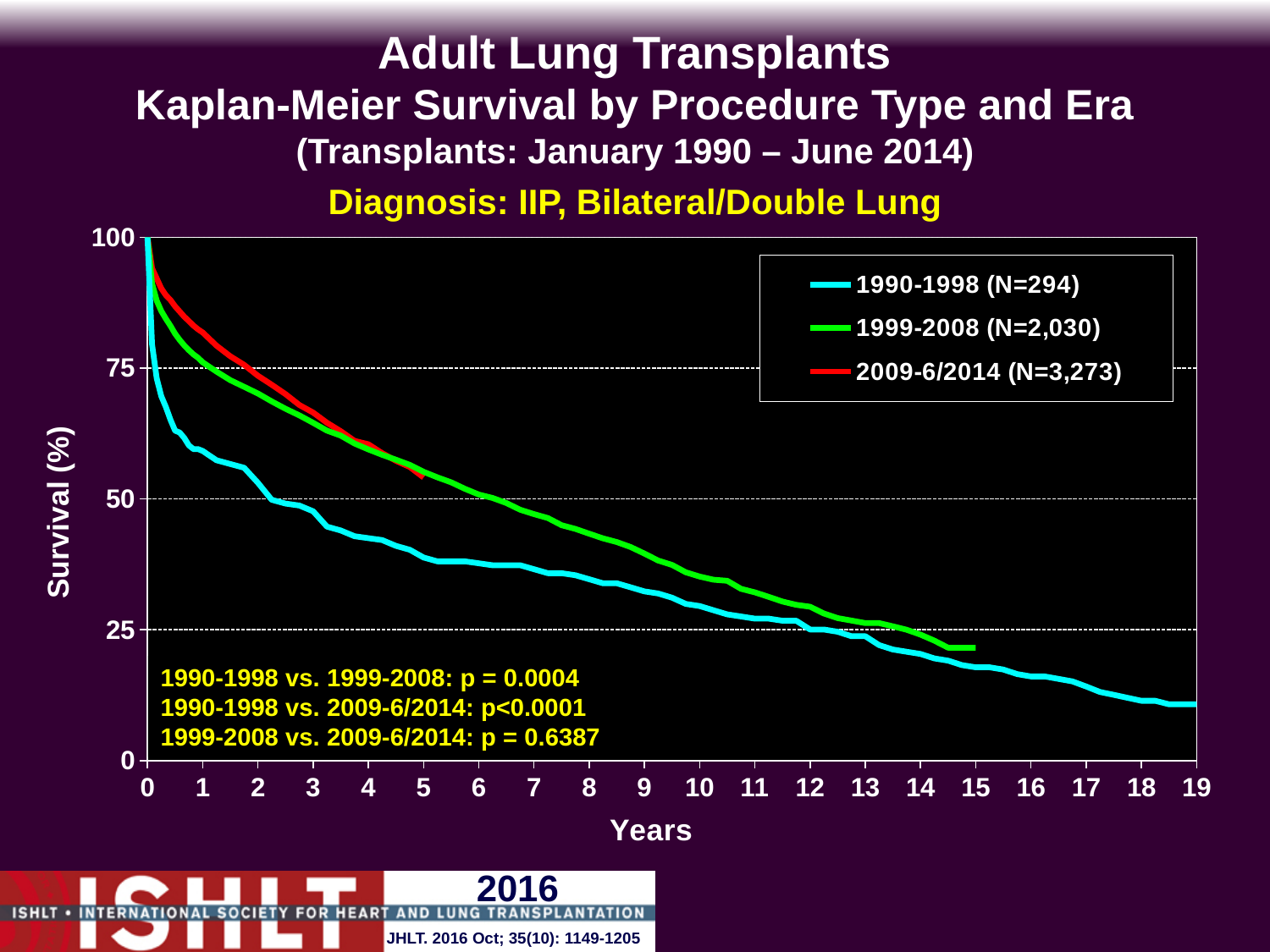
Is the survival value for the 2009-6/2014 series at 1 year greater or less than 75? greater Is the survival value for the 1990-1998 series at 5 years greater or less than 50? less Is the survival value for the 1990-1998 series at 15 years greater or less than 25? less What is the N shown in the legend for the 1999-2008 series? N=2,030 At 5 years, which series has higher survival: 1990-1998 or 1999-2008? 1999-2008 What p-value is shown for 1990-1998 vs. 1999-2008? p = 0.0004 How many series does the legend list? 3 Do the survival curves rise or fall as years increase? fall Which series has the lowest survival at 5 years? 1990-1998 What kind of chart is shown on the slide? line chart